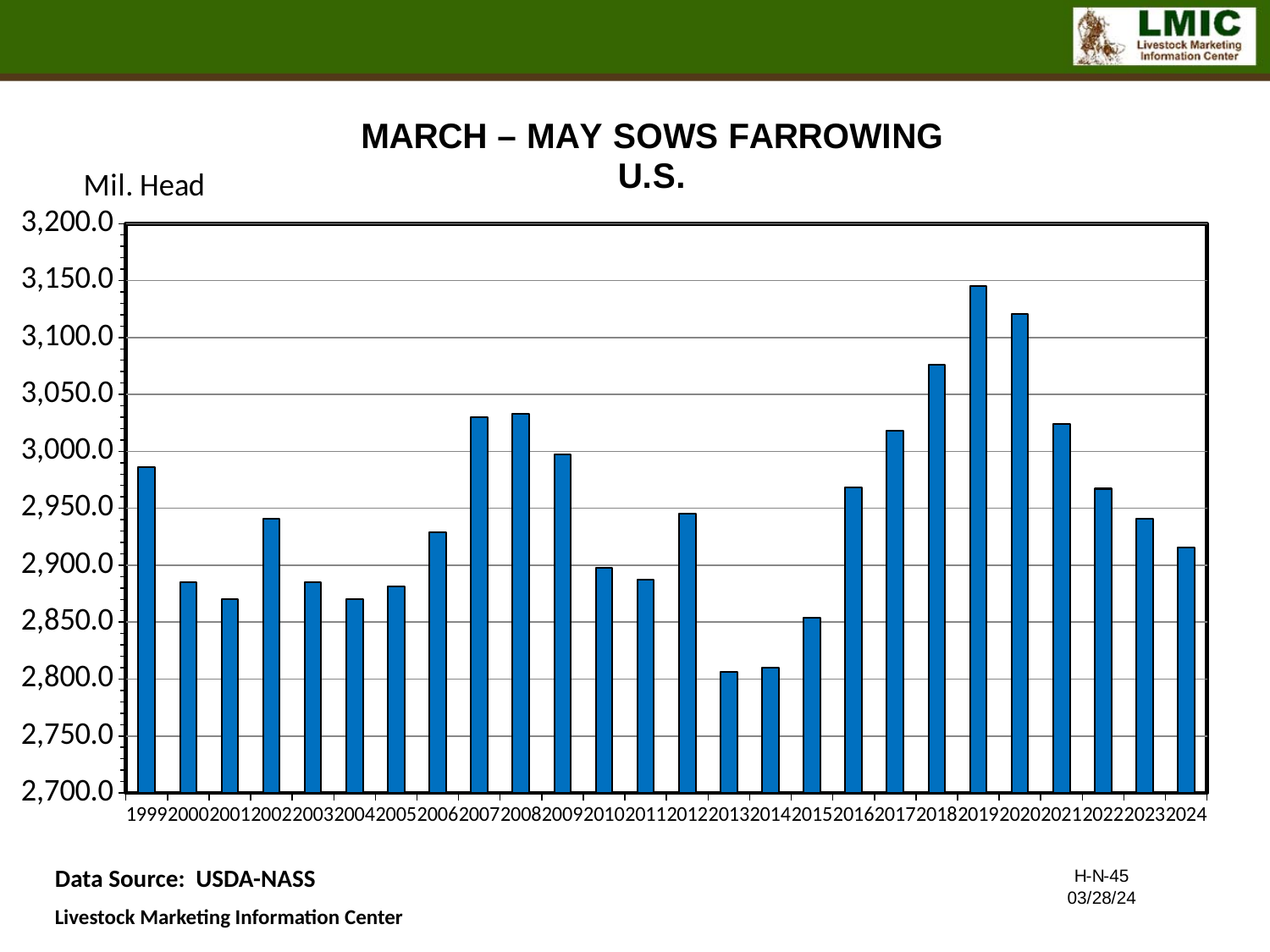
How many years are plotted on the x axis? 26 Is the value for 2007 greater or less than 3,000.0? greater Is the value for 2019 greater or less than 3,100.0? greater Which year has the highest value for March–May sows farrowing? 2019 Which year has the larger value, 2017 or 2018? 2018 Is the value for 2016 greater or less than 2,950.0? greater Which year has the larger value, 2019 or 2020? 2019 Do the values rise or fall from 2013 to 2019? rise What unit label is shown above the y axis? Mil. Head What kind of chart is shown on the slide? bar chart